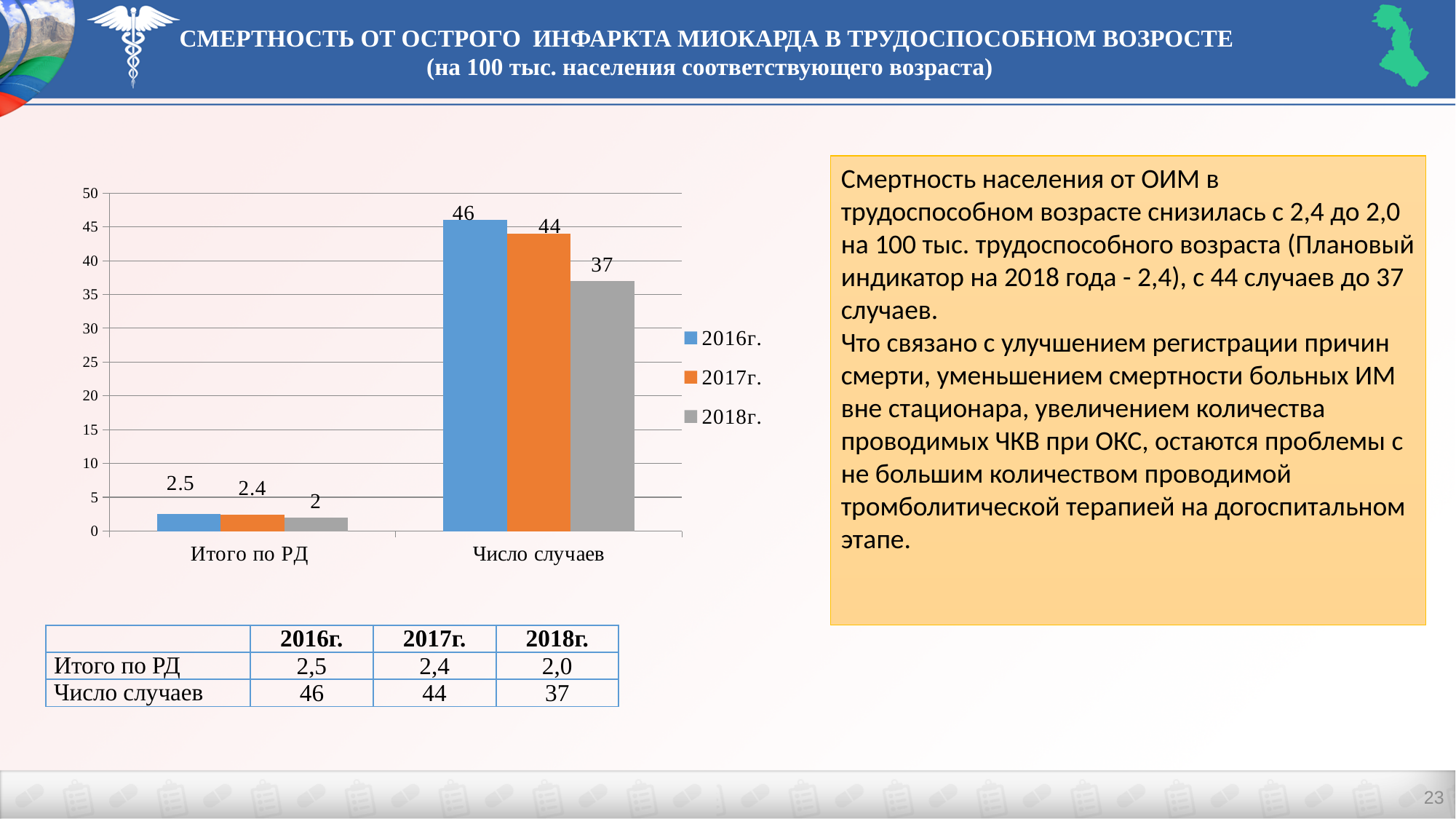
Which year has the highest value in the category Итого по РД? 2016г. Which colour represents the series 2017г. in the chart? orange Do the values in the category Число случаев rise or fall from 2016г. to 2018г.? fall How many series does the chart legend list? 3 Which is larger in the category Число случаев: the value for 2017г. or the value for 2018г.? 2017г. Which year has the lowest value in the category Число случаев? 2018г. What is the value for 2017г. in the category Число случаев? 44 How many categories are shown on the x axis of the chart? 2 What is the difference between the 2016г. and 2018г. values in the category Число случаев? 9 What is the value for 2016г. in the category Число случаев? 46 What type of chart is shown on the slide? bar chart What is the value for 2018г. in the category Итого по РД? 2